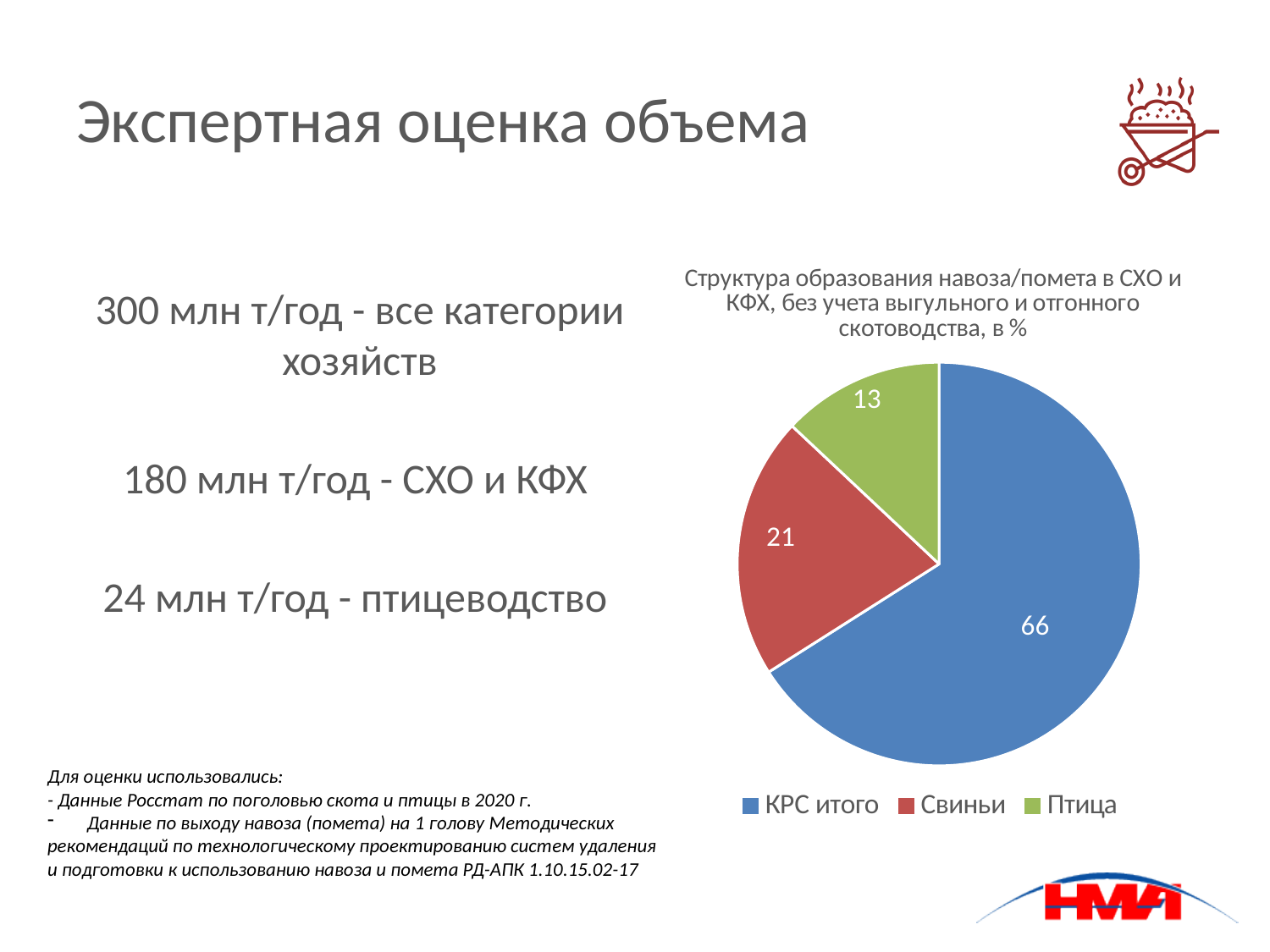
What value is shown for КРС итого in the pie chart? 66 Which category has the smallest slice in the pie chart? Птица Which is larger, the slice for Свиньи or the slice for Птица? Свиньи What type of chart is shown on the slide? Pie chart How many slices does the pie chart have? 3 How many entries does the chart legend list? 3 What colour is the slice for Птица in the pie chart? Green Which category has the largest slice in the pie chart? КРС итого What is the difference between the values for КРС итого and Свиньи? 45 What value is shown for Свиньи in the pie chart? 21 What is the difference between the values for Свиньи and Птица? 8 What value is shown for Птица in the pie chart? 13